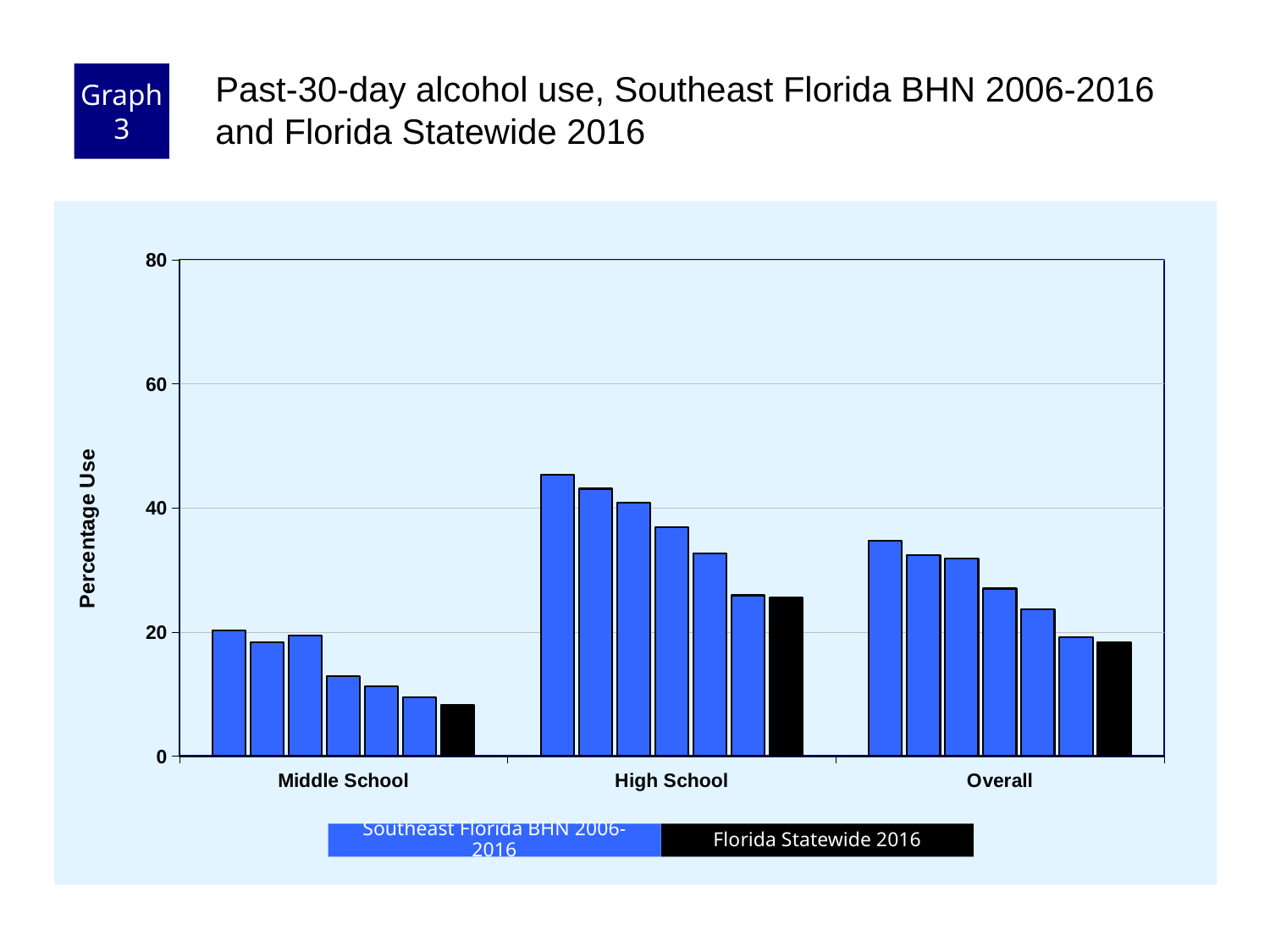
Is the tallest Southeast Florida BHN bar for Overall greater or less than 40? less Within the High School group, do the Southeast Florida BHN bars rise or fall from 2006 to 2016? fall What is the label on the y axis? Percentage Use Which category has the lowest bars? Middle School Is the Florida Statewide 2016 value for High School greater or less than 20? greater How many series does the legend list? 2 What kind of chart is shown on the slide? bar chart How many school-level categories are shown on the x axis? 3 How many bars are plotted in the High School group? 7 Which category has the tallest bar overall? High School Is the tallest Southeast Florida BHN bar for High School greater or less than 40? greater